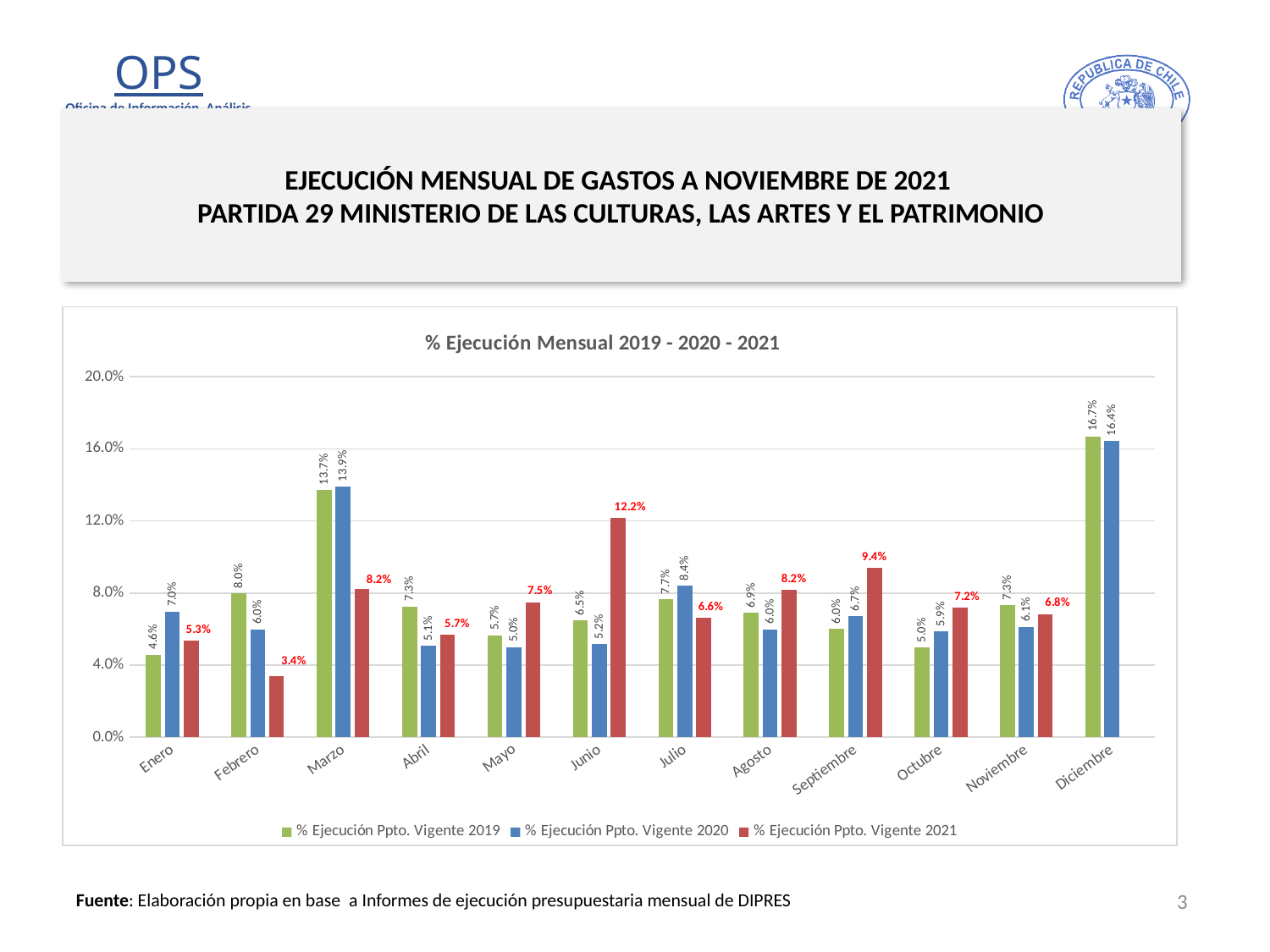
What kind of chart is shown? Bar chart What is the % Ejecución Ppto. Vigente 2021 value for Junio? 12.2% How many months are shown on the x axis? 12 How many series does the legend list? 3 What is the difference between the 2021 and 2020 values for Junio? 7.0% What is the % Ejecución Ppto. Vigente 2019 value for Marzo? 13.7% Which month has the lowest % Ejecución Ppto. Vigente 2021 value? Febrero Is the % Ejecución Ppto. Vigente 2020 value for Marzo greater or less than 12.0%? greater Which is larger for Septiembre: the 2019 value or the 2021 value? 2021 value What is the title of the chart? % Ejecución Mensual 2019 - 2020 - 2021 Which month has the highest % Ejecución Ppto. Vigente 2019 value? Diciembre What is the % Ejecución Ppto. Vigente 2020 value for Diciembre? 16.4%